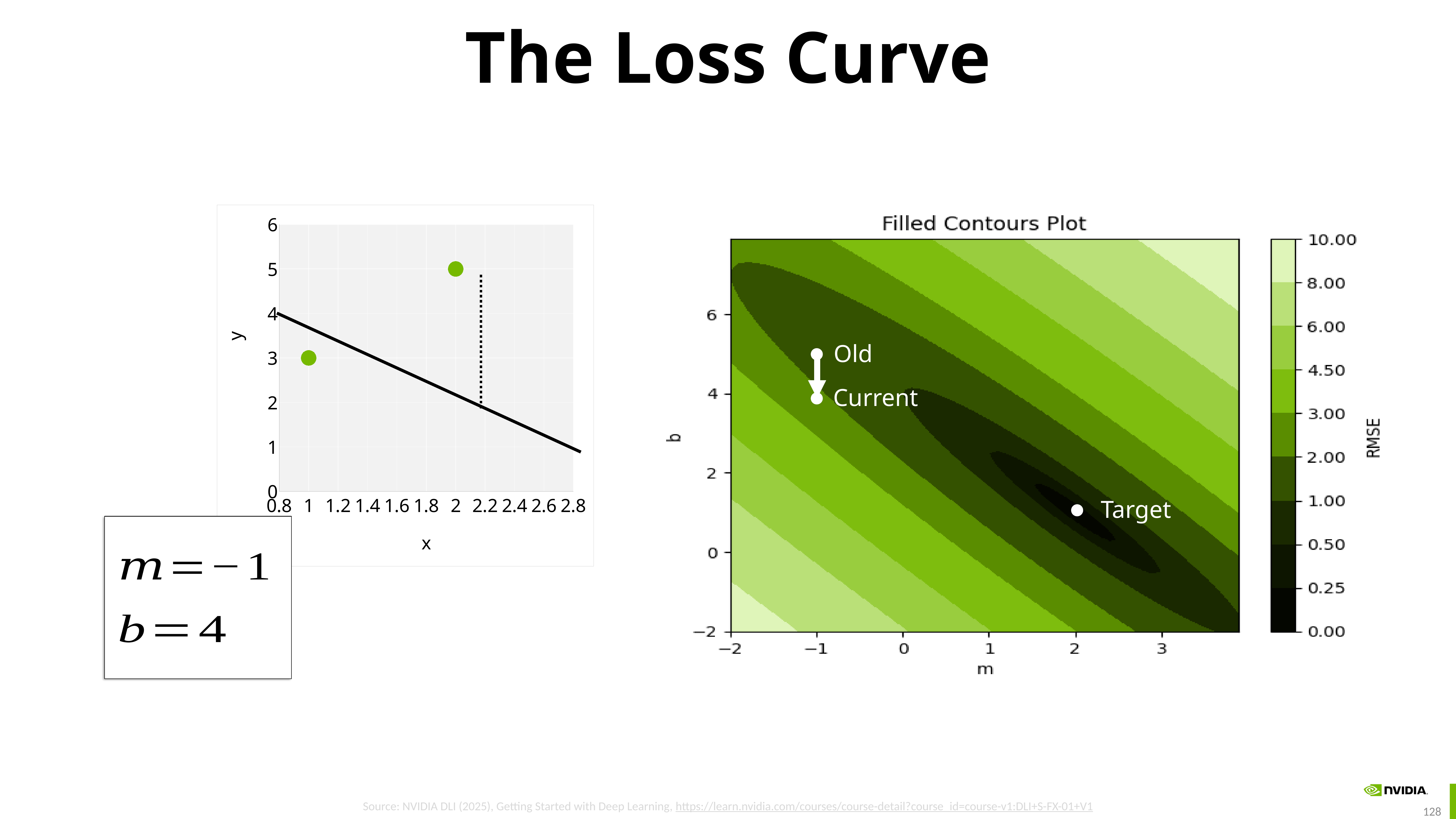
In the right chart, what is the m value of the point labelled Target? 2 In the right chart, what is the b value of the point labelled Current? 4 In the left chart, how many green data points are plotted? 2 In the right chart, what is the highest value shown on the colour bar? 10.00 In the right chart, is the b value of the point labelled Old greater or less than 4? greater In the left chart, what is the y value of the data point at x = 2? 5 In the left chart, what is the y value of the data point at x = 1? 3 In the left chart, which data point has the higher y value, the one at x = 1 or the one at x = 2? x = 2 In the left chart, does the black line rise or fall as x increases? fall What is the title of the right chart? Filled Contours Plot What kind of chart is the left chart? scatter plot In the right chart, what quantity does the colour bar represent? RMSE